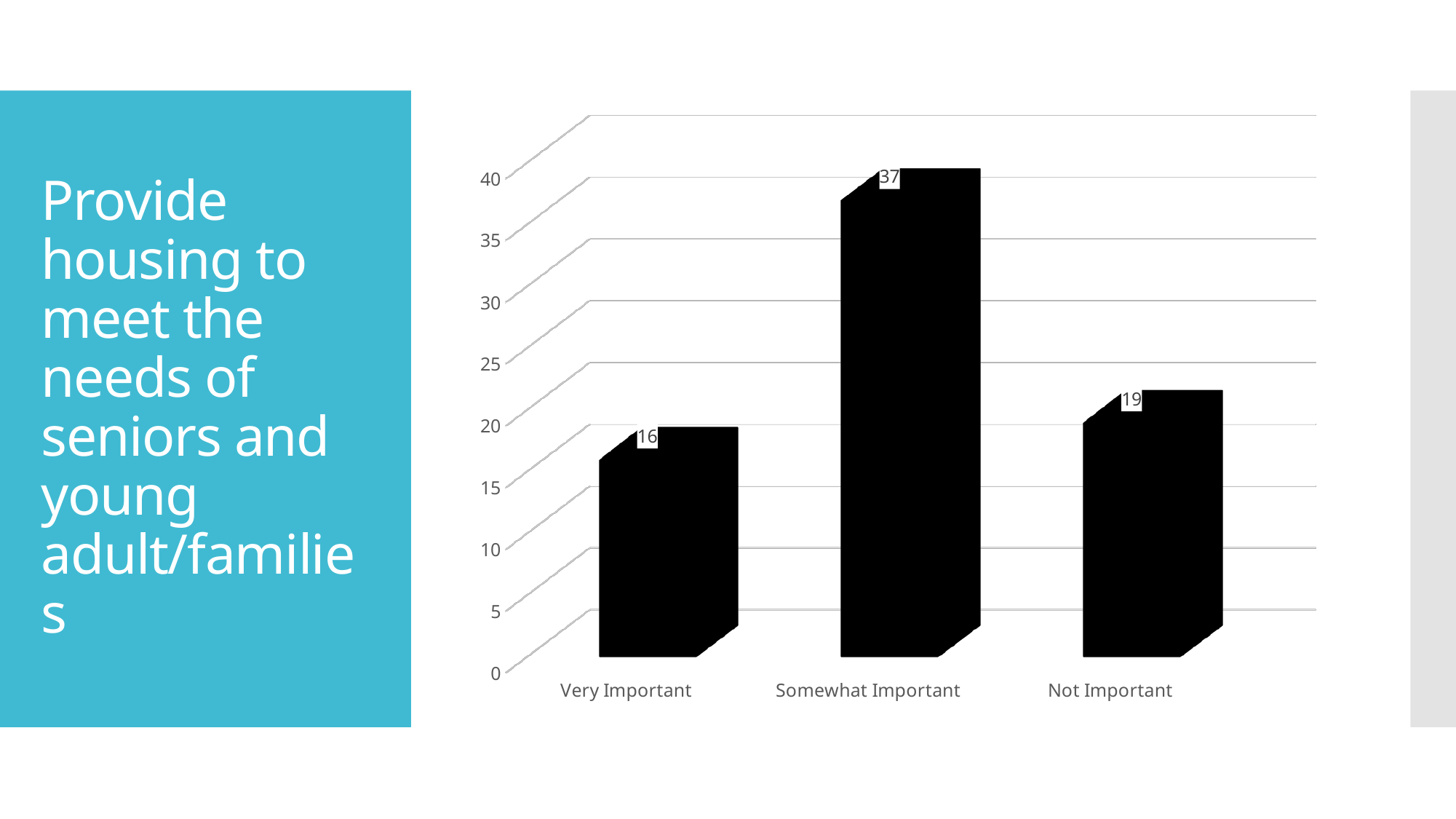
Which category has the lowest value? Very Important What is the difference between the values for Not Important and Very Important? 3 What is the value for Somewhat Important? 37 What kind of chart is shown on the slide? bar chart Is the value for Somewhat Important greater or less than 30? greater What is the value for Not Important? 19 What is the difference between the values for Somewhat Important and Very Important? 21 What is the title text on the left of the slide? Provide housing to meet the needs of seniors and young adult/families How many categories are shown on the x axis? 3 Which category has the highest value? Somewhat Important Which is larger, the value for Not Important or the value for Very Important? Not Important What is the value for Very Important? 16